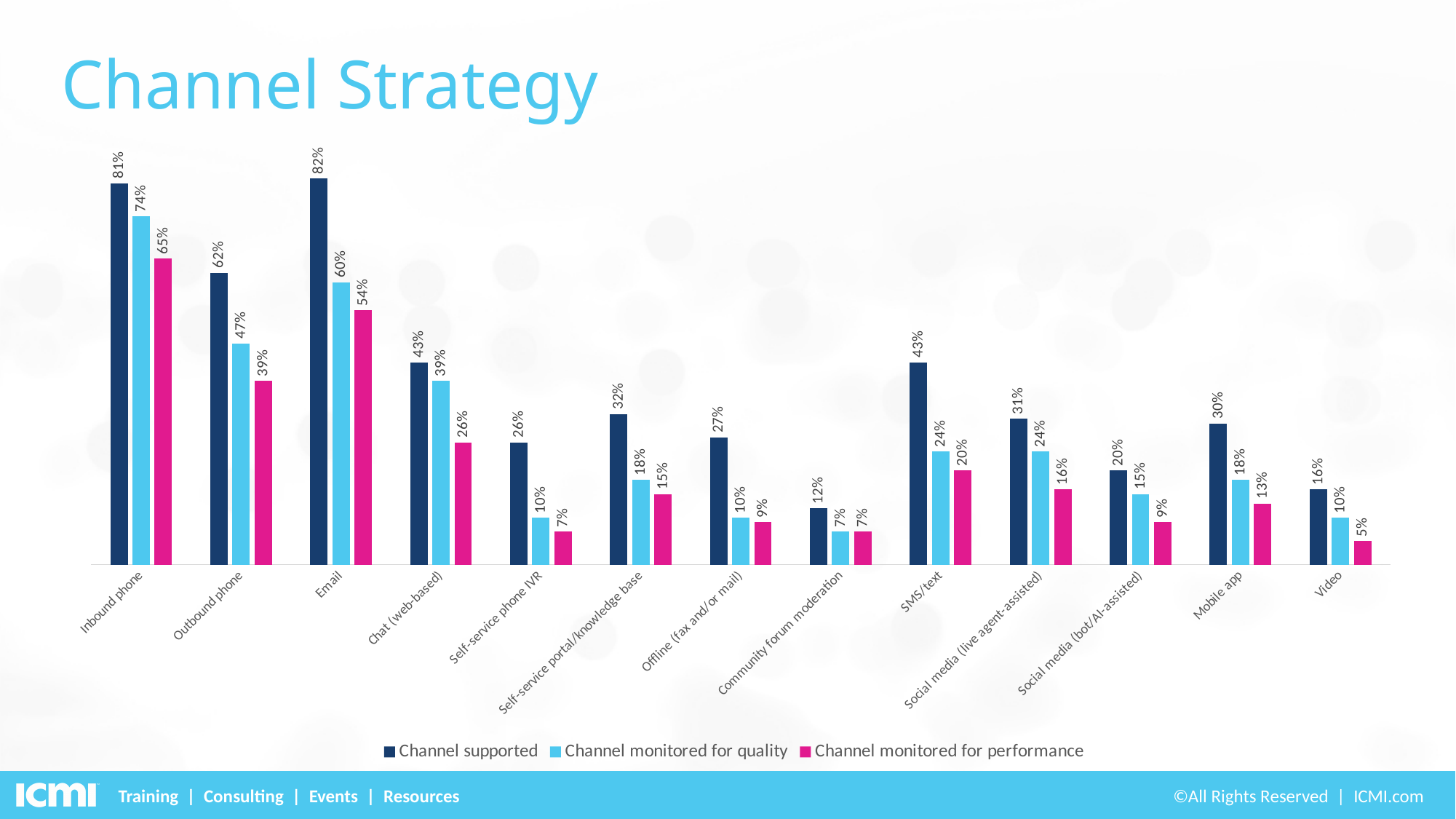
What kind of chart is shown on the slide? Bar chart What is the 'Channel supported' value for Email? 82% Which channel has the lowest 'Channel monitored for performance' value? Video What is the difference between the 'Channel supported' and 'Channel monitored for performance' values for Inbound phone? 16% What is the 'Channel monitored for quality' value for Outbound phone? 47% Which channel has the highest 'Channel supported' value? Email Which is larger: the 'Channel supported' value for Mobile app or for Social media (live agent-assisted)? Social media (live agent-assisted) How many channels (categories) are shown on the x axis? 13 How many series does the legend list? 3 What is the 'Channel monitored for performance' value for SMS/text? 20% What is the title of the slide? Channel Strategy What is the 'Channel monitored for quality' value for Self-service portal/knowledge base? 18%